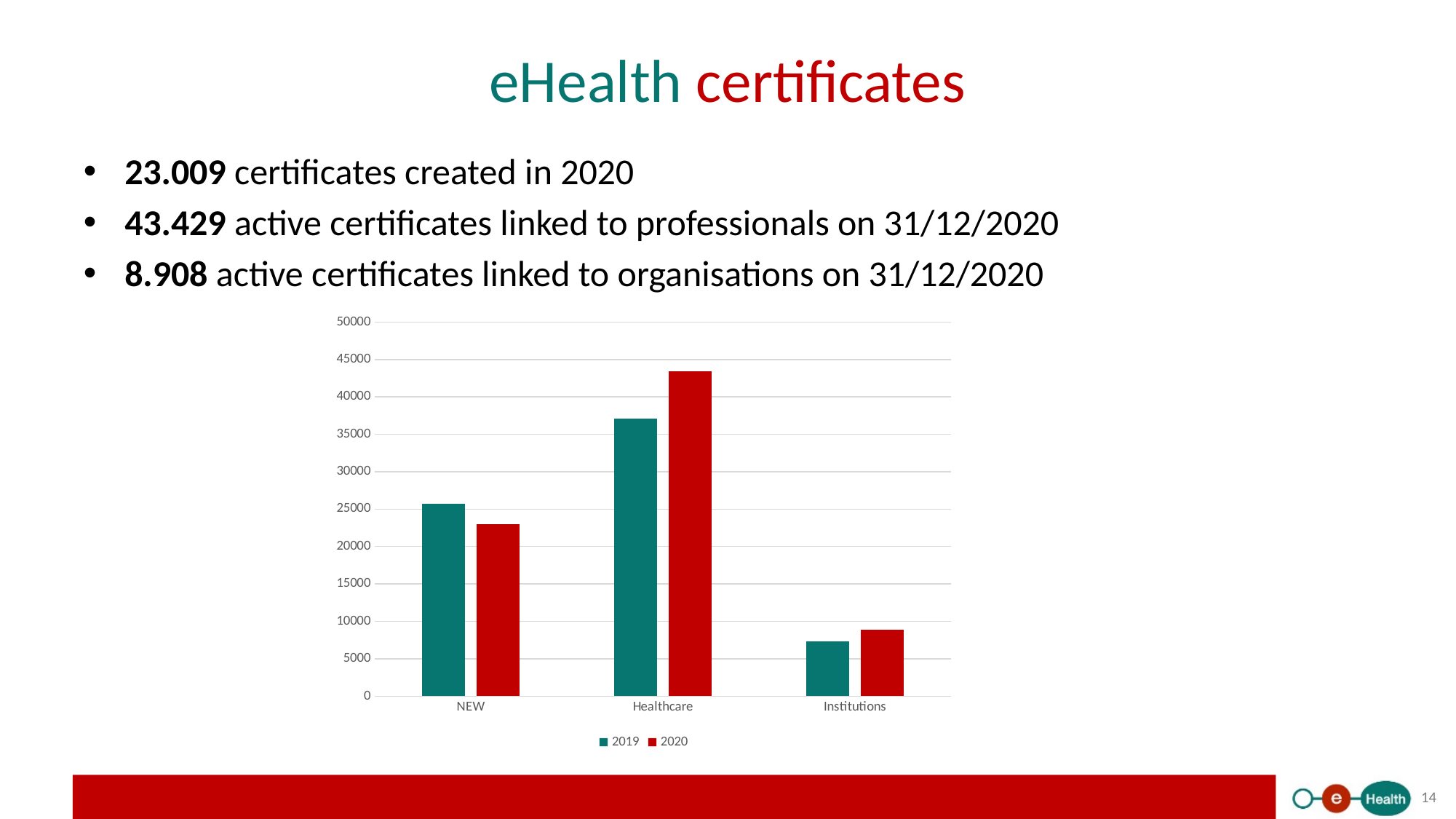
Which colour represents the 2020 series in the chart? red Is the 2019 value for NEW greater or less than 25000? greater Which category has the lowest bar in the chart? Institutions How many categories are shown on the x axis of the chart? 3 What are the two series listed in the chart legend? 2019 and 2020 For the Healthcare category, which year has the larger value, 2019 or 2020? 2020 Is the 2020 value for Institutions greater or less than 10000? less What kind of chart is shown on the slide? bar chart Which category has the highest bar in the chart? Healthcare How many series does the chart legend list? 2 For the NEW category, which year has the larger value, 2019 or 2020? 2019 Is the 2020 value for Healthcare greater or less than 40000? greater